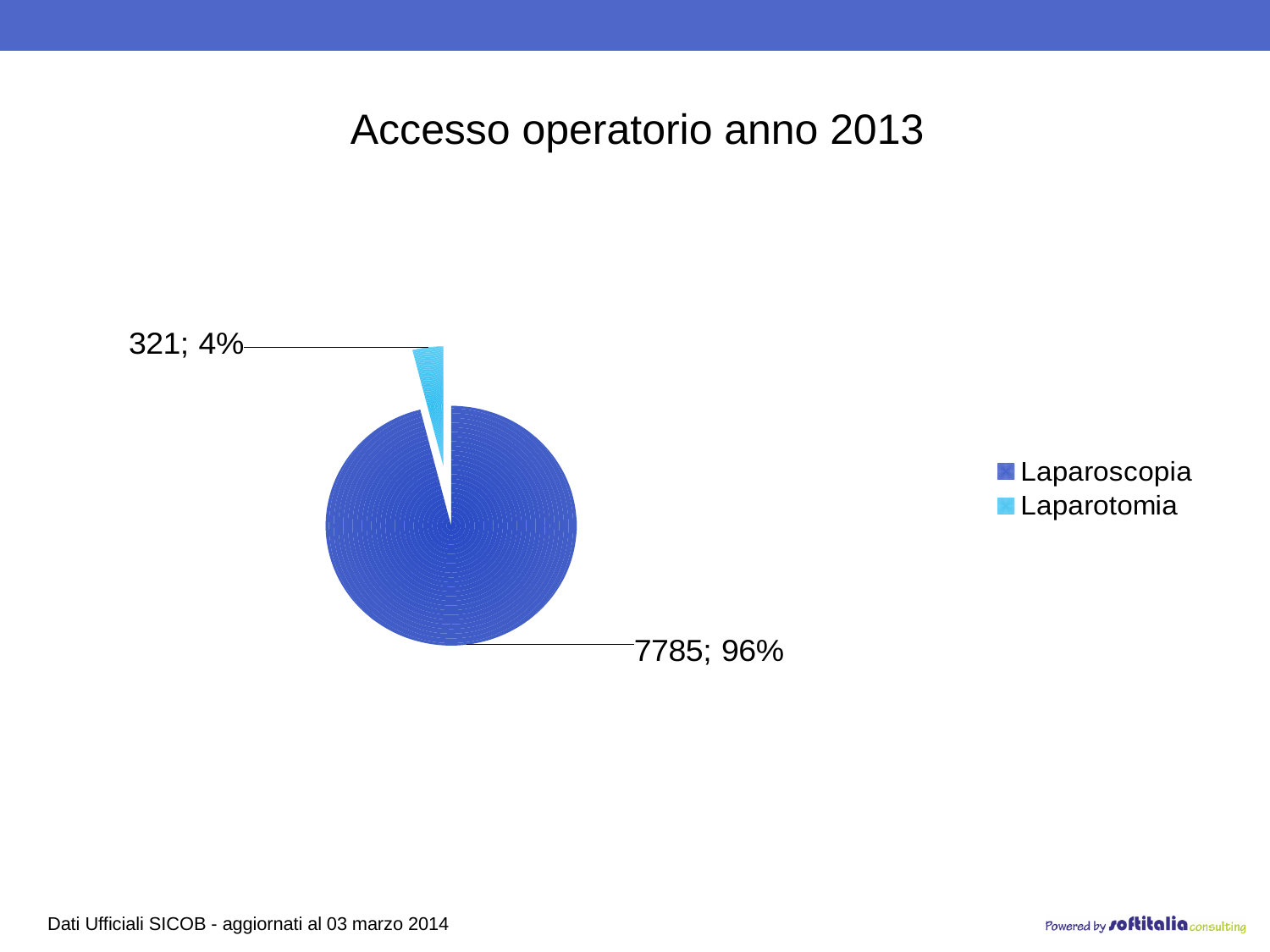
Which category has the largest slice? Laparoscopia How many slices does the pie chart have? 2 What kind of chart is shown on the slide? pie chart What is the total of the two slices in the pie chart? 8106 What is the value for Laparoscopia? 7785 How many entries does the legend list? 2 What share of the pie does Laparotomia represent? 4% What share of the pie does Laparoscopia represent? 96% What is the title of the chart? Accesso operatorio anno 2013 Which category has the smallest slice? Laparotomia What is the difference between the values for Laparoscopia and Laparotomia? 7464 What is the value for Laparotomia? 321